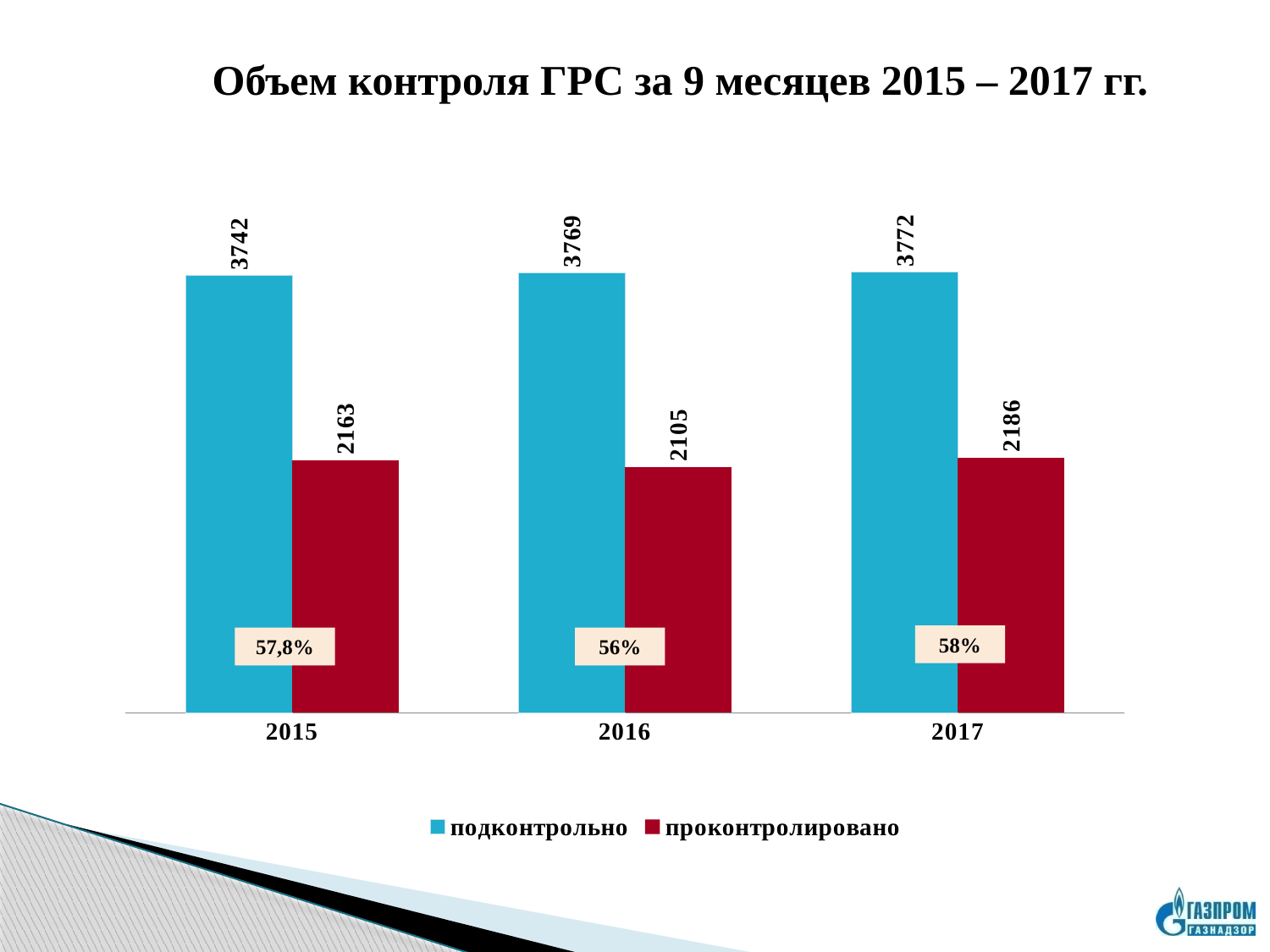
What is the value of проконтролировано for 2016? 2105 What kind of chart is shown on the slide? bar chart What is the difference between подконтрольно and проконтролировано in 2017? 1586 Which year has the highest value of проконтролировано? 2017 What is the value of подконтрольно for 2017? 3772 Which year has the lowest value of проконтролировано? 2016 How many series does the legend list? 2 What is the difference between проконтролировано in 2015 and 2016? 58 What is the value of подконтрольно for 2015? 3742 Which is larger in 2016: подконтрольно or проконтролировано? подконтрольно What percentage label is shown for 2015? 57,8% How many years are shown on the x axis? 3